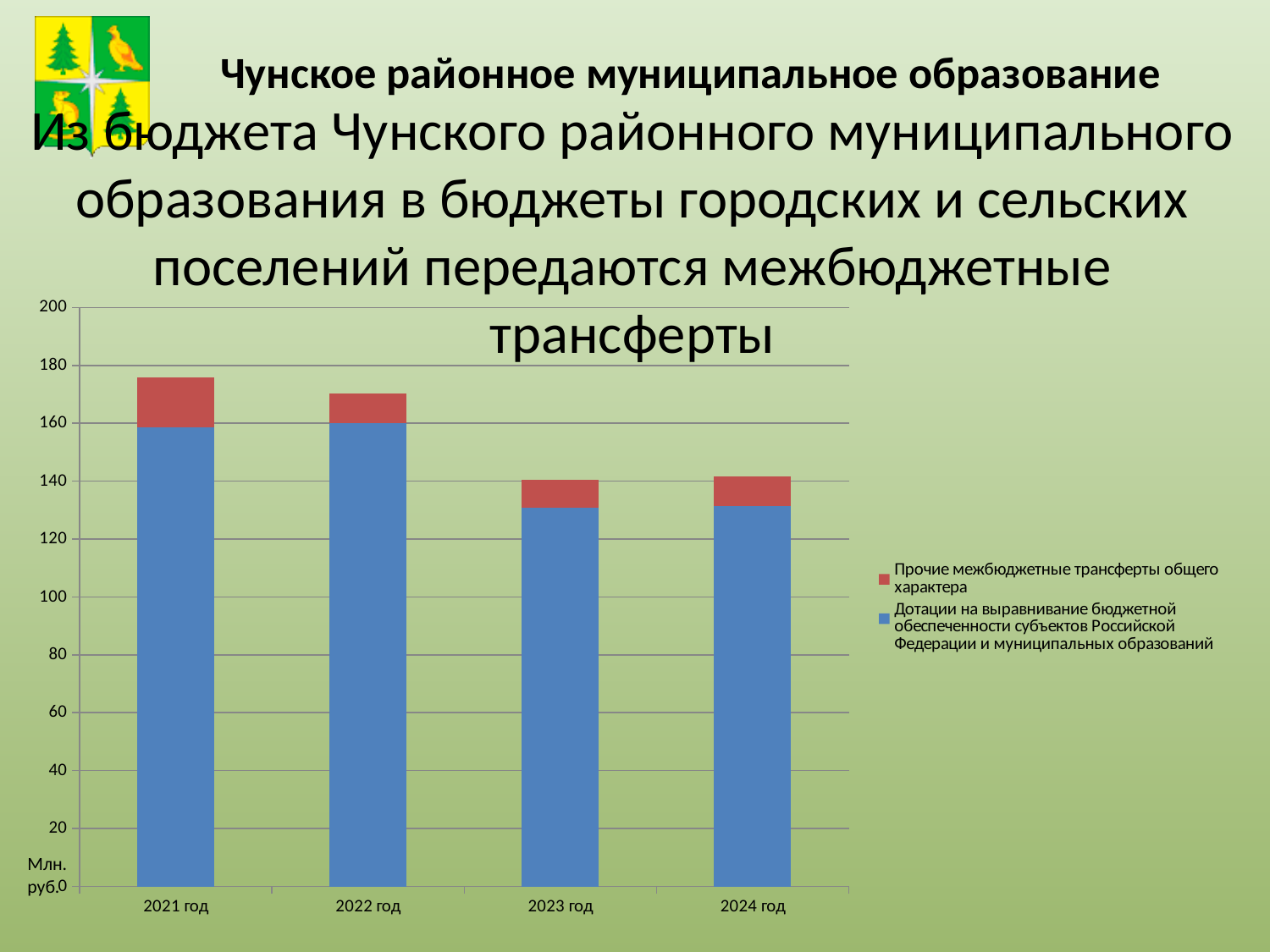
Is the total bar for 2024 год greater or less than 120? greater What kind of chart is shown on the slide? Stacked bar chart How many years are shown on the x axis of the chart? 4 Is the value of Дотации на выравнивание бюджетной обеспеченности for 2023 год greater or less than 140? less Which colour represents Прочие межбюджетные трансферты общего характера in the chart? Red Which total bar is larger, 2021 год or 2023 год? 2021 год Is the total bar for 2021 год greater or less than 160? greater Which year has the highest total bar in the chart? 2021 год How many series does the chart legend list? 2 Do the total bars rise or fall from 2021 год to 2023 год? fall What unit is shown on the vertical axis of the chart? Млн. руб.